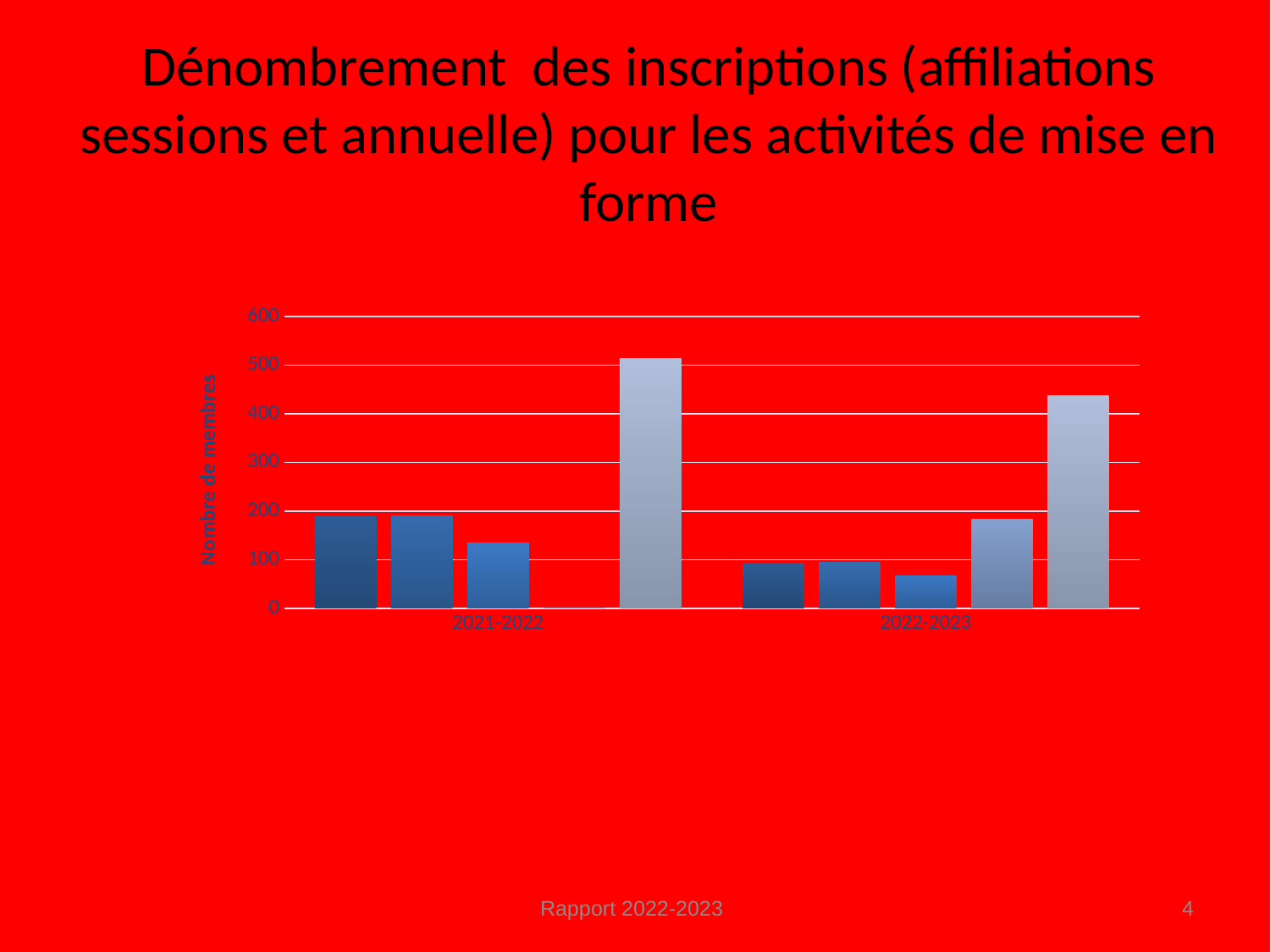
How many categories are shown on the x axis of the chart? 2 What is the highest tick value shown on the vertical axis? 600 What kind of chart is shown on the slide? bar chart Which category contains the tallest bar in the chart, 2021-2022 or 2022-2023? 2021-2022 Is the value of the tallest bar in the 2022-2023 group greater or less than 400? greater Is the value of the tallest bar in the 2021-2022 group greater or less than 400? greater Which is larger: the tallest bar in 2021-2022 or the tallest bar in 2022-2023? the tallest bar in 2021-2022 How many bars are visible in the 2022-2023 group? 5 Does the tallest bar rise or fall from 2021-2022 to 2022-2023? fall Is the value of the first (leftmost) bar in the 2021-2022 group greater or less than 300? less What is the title of the vertical axis of the chart? Nombre de membres